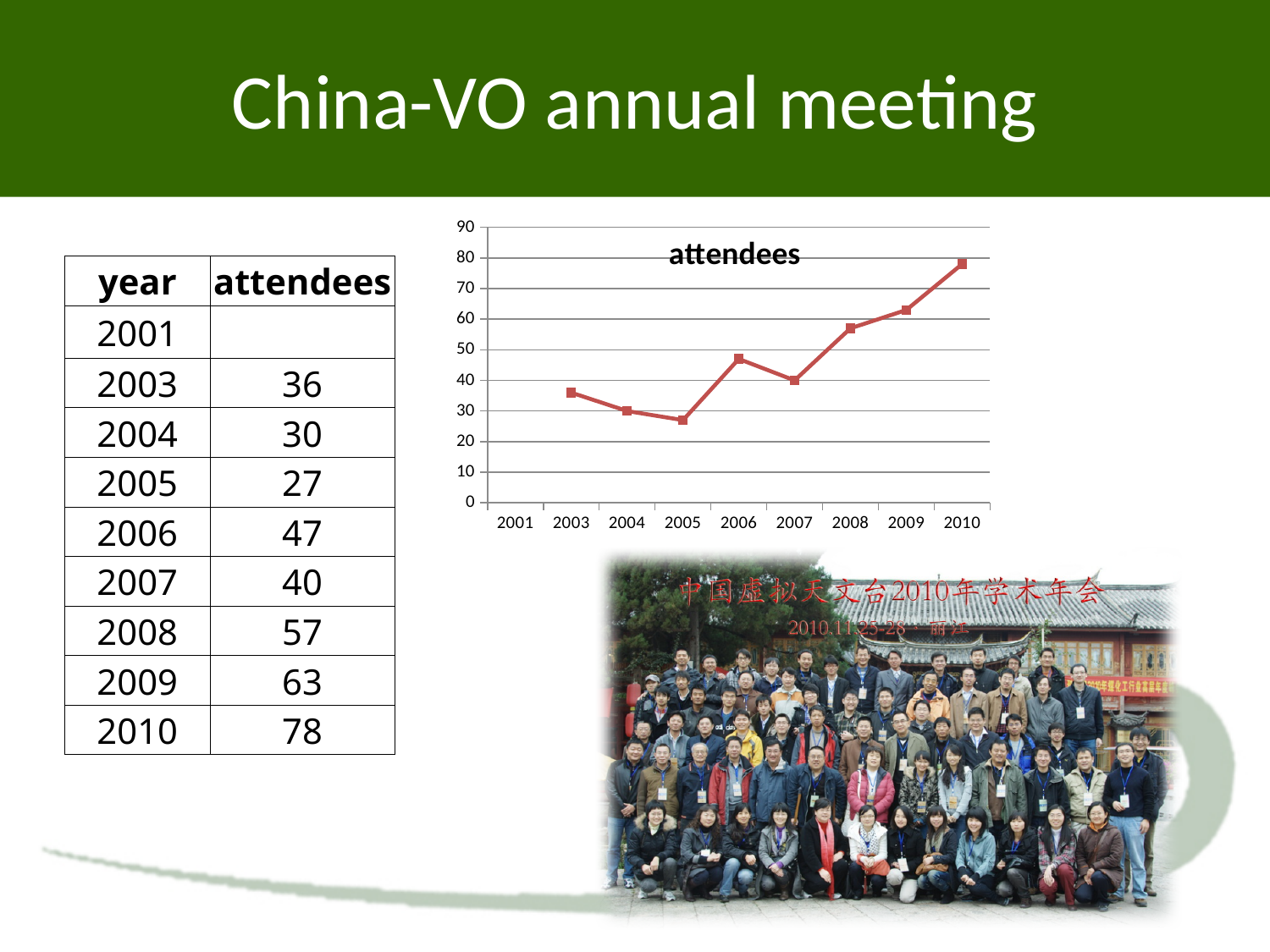
What type of chart is shown on the slide? line chart Which year had the highest number of attendees? 2010 Which year with a plotted value had the lowest number of attendees? 2005 Do the attendee numbers generally rise or fall from 2005 to 2010? rise How many attendees were there in 2005? 27 How many attendees were there in 2010? 78 What is the difference in attendees between 2006 and 2005? 20 What is the difference in attendees between 2010 and 2009? 15 What is the title of the chart? attendees How many years are labelled on the x axis of the chart? 9 Which year had more attendees, 2006 or 2007? 2006 Is the value for 2008 greater or less than 50? greater